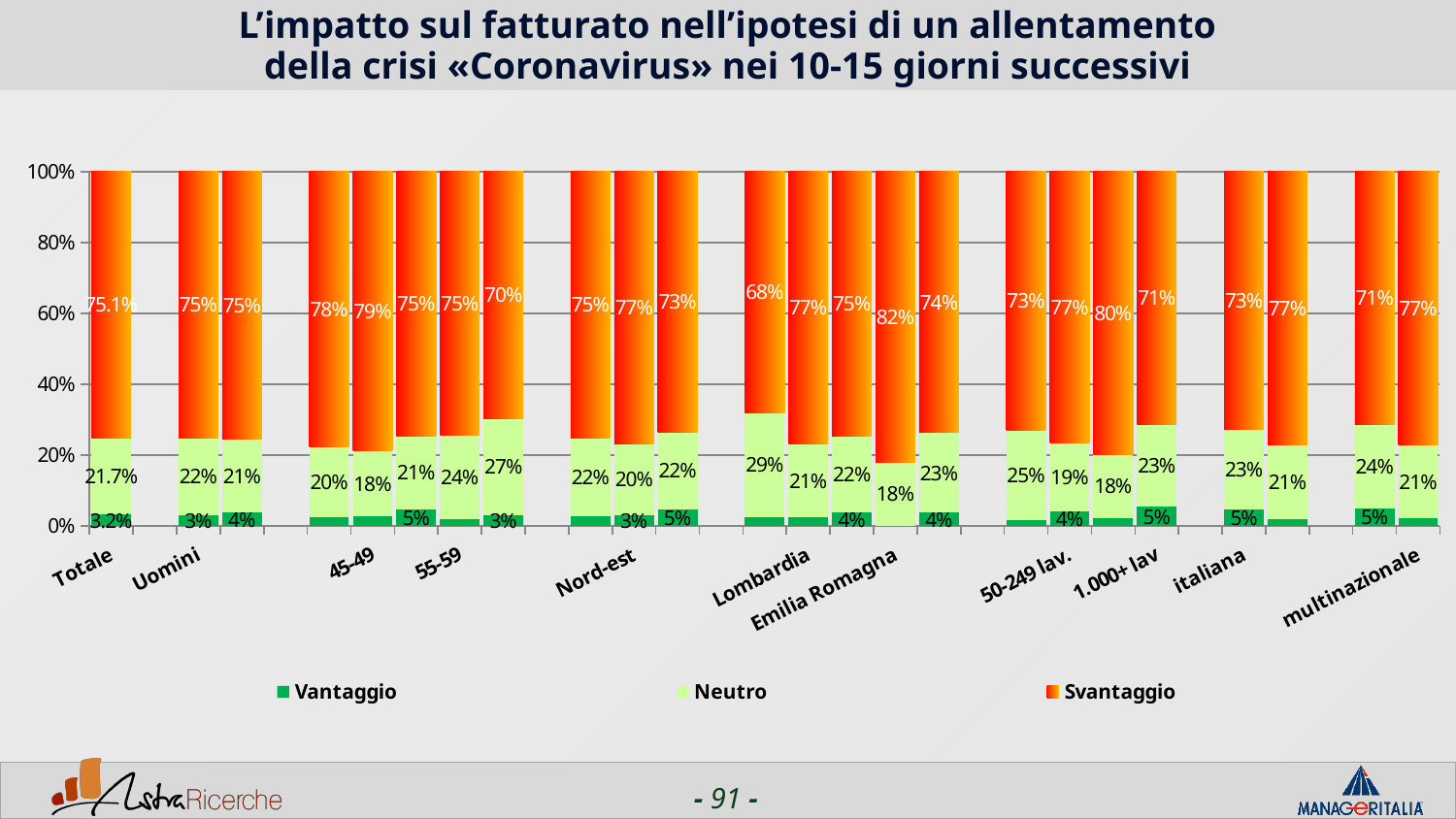
What are the three series named in the legend? Vantaggio, Neutro, Svantaggio What is the Svantaggio value for Totale? 75.1% What kind of chart is shown on the slide? Stacked bar chart What is the highest Neutro value labelled on any bar? 29% What is the Neutro value for Totale? 21.7% How many series does the legend list? 3 Is the Svantaggio value for Totale greater or less than 60%? greater What is the Vantaggio value for Totale? 3.2% For Totale, which is larger: the Svantaggio share or the Neutro share? Svantaggio What is the lowest Svantaggio value labelled on any bar? 68% What is the difference between the Svantaggio and Neutro values for Totale? 53.4% What is the highest Svantaggio value labelled on any bar? 82%